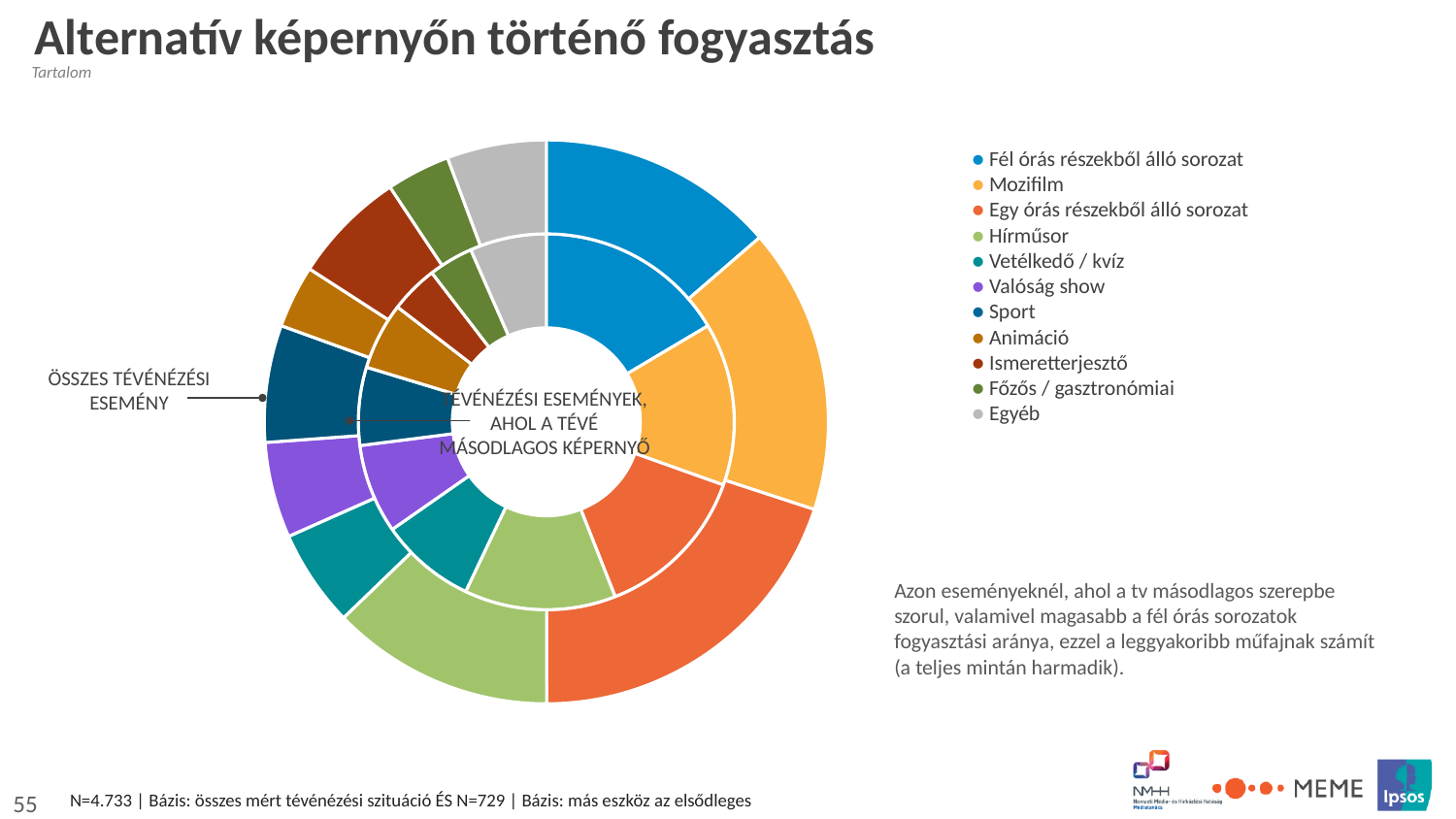
What kind of chart is shown on the slide? doughnut chart In the inner ring, which slice is larger: Mozifilm or Sport? Mozifilm Which category is the last entry in the chart's legend? Egyéb How many rings does the doughnut chart have? 2 In the inner ring (TÉVÉNÉZÉSI ESEMÉNYEK, AHOL A TÉVÉ MÁSODLAGOS KÉPERNYŐ), which category has the largest slice? Fél órás részekből álló sorozat In the outer ring (ÖSSZES TÉVÉNÉZÉSI ESEMÉNY), which slice is larger: Mozifilm or Valóság show? Mozifilm In the outer ring, which slice is larger: Egy órás részekből álló sorozat or Ismeretterjesztő? Egy órás részekből álló sorozat How many categories does the legend of the chart list? 11 What label is given to the outer ring of the doughnut chart? ÖSSZES TÉVÉNÉZÉSI ESEMÉNY Which category is the first entry in the chart's legend? Fél órás részekből álló sorozat